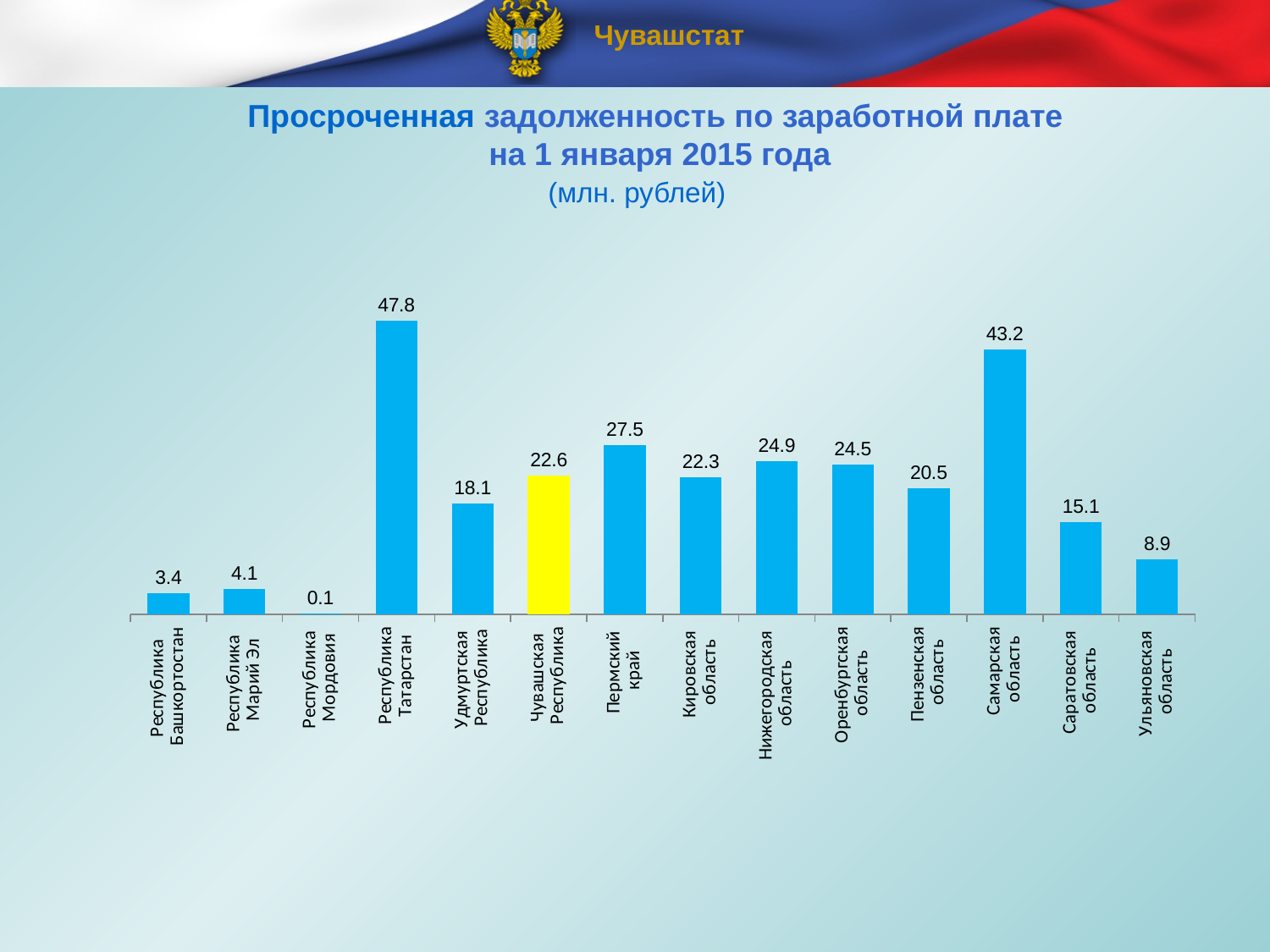
What is the difference between the values for Пермский край and Чувашская Республика? 4.9 How many regions are shown in the chart? 14 What is the difference between the values for Республика Татарстан and Самарская область? 4.6 Which region has the highest value? Республика Татарстан What is the value for Саратовская область? 15.1 Which region has the lowest value? Республика Мордовия What kind of chart is shown on the slide? Bar chart Which is larger, the value for Нижегородская область or Пензенская область? Нижегородская область Which is larger, the value for Ульяновская область or Республика Марий Эл? Ульяновская область What is the value for Чувашская Республика? 22.6 What is the value for Республика Татарстан? 47.8 Which region's bar is highlighted in yellow? Чувашская Республика